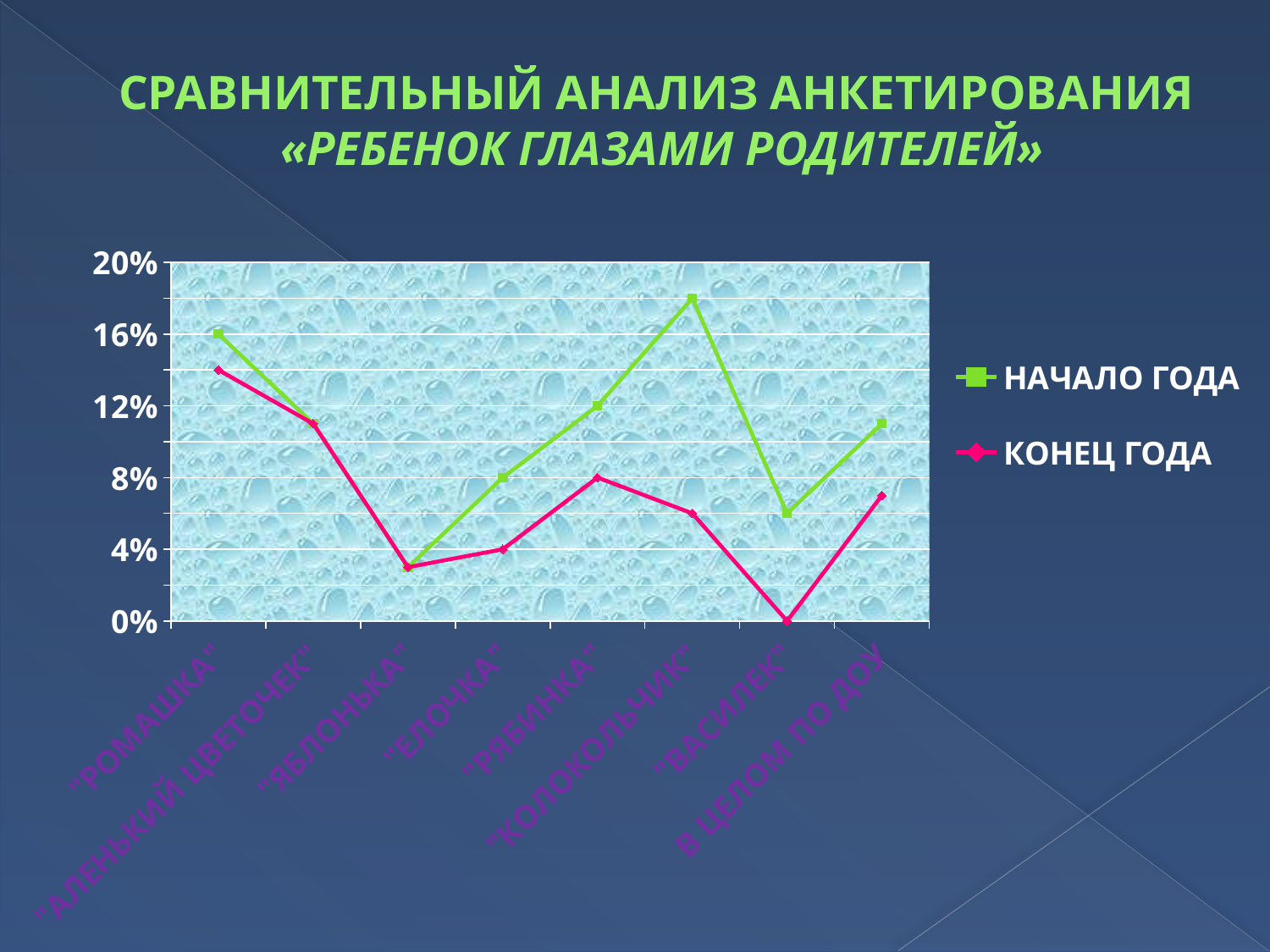
Which category has the lowest value in the КОНЕЦ ГОДА series? "ВАСИЛЕК" How many categories are shown along the x axis? 8 What is the difference between the НАЧАЛО ГОДА and КОНЕЦ ГОДА values for "РЯБИНКА"? 4% What is the value for "РЯБИНКА" in the НАЧАЛО ГОДА series? 12% How many series does the legend list? 2 Which category has the highest value in the НАЧАЛО ГОДА series? "КОЛОКОЛЬЧИК" What is the value for "РОМАШКА" in the НАЧАЛО ГОДА series? 16% Is the value for "КОЛОКОЛЬЧИК" in the НАЧАЛО ГОДА series greater or less than 16%? greater What is the value for "ВАСИЛЕК" in the КОНЕЦ ГОДА series? 0% Is the value for "АЛЕНЬКИЙ ЦВЕТОЧЕК" in the КОНЕЦ ГОДА series greater or less than 12%? less For "КОЛОКОЛЬЧИК", which series has the larger value, НАЧАЛО ГОДА or КОНЕЦ ГОДА? НАЧАЛО ГОДА What kind of chart is shown on the slide? line chart